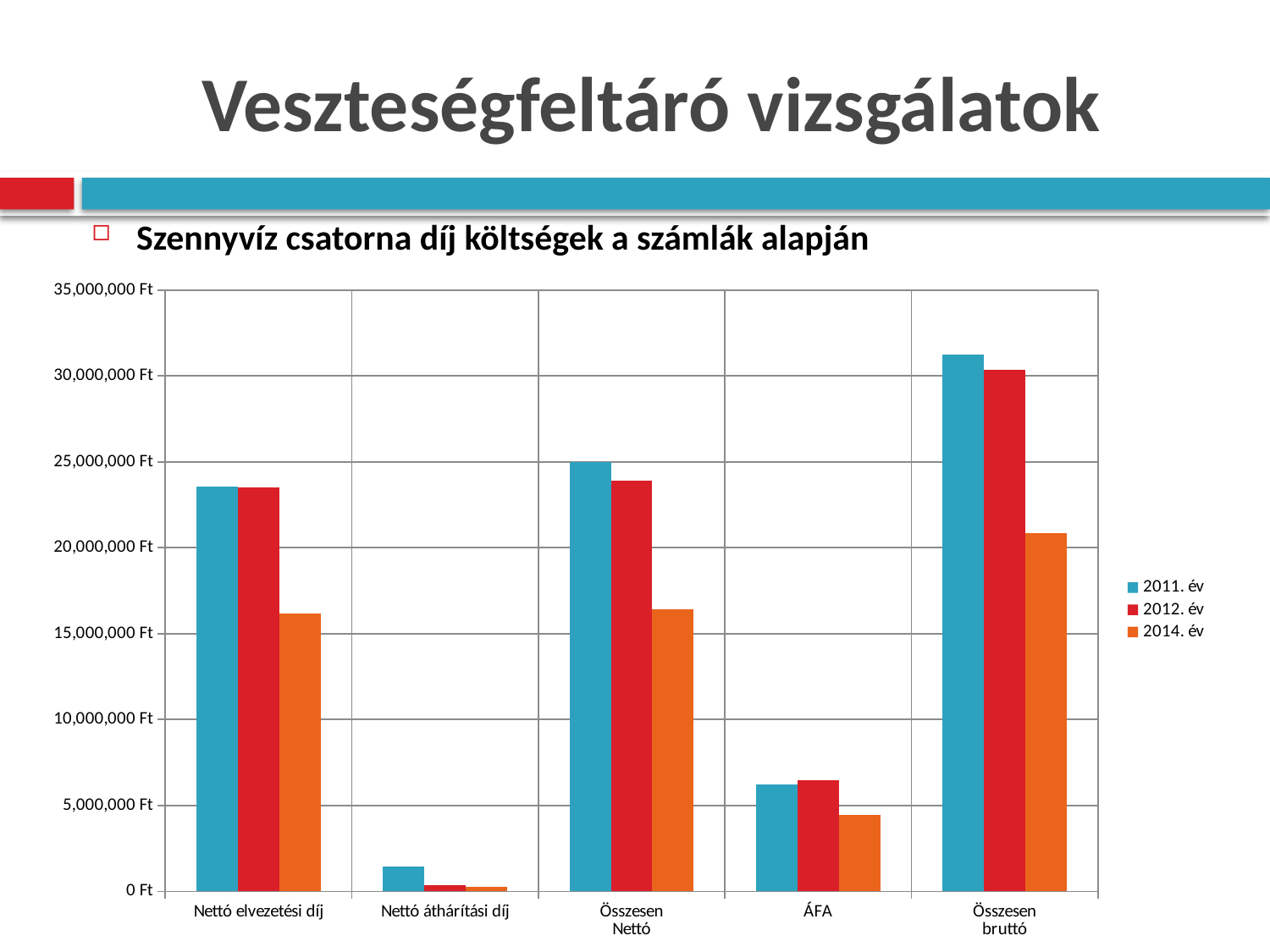
What kind of chart is shown on the slide? bar chart Which series is shown in orange in the legend? 2014. év How many categories are shown on the x axis? 5 Which category has the lowest value for the 2014. év series? Nettó áthárítási díj How many series does the legend list? 3 Is the 2011. év value for Összesen bruttó greater or less than 30,000,000 Ft? greater Is the 2011. év value for Nettó áthárítási díj greater or less than 5,000,000 Ft? less Is the 2014. év value for Nettó elvezetési díj greater or less than 15,000,000 Ft? greater For Összesen Nettó, which series has the larger value: 2011. év or 2012. év? 2011. év Which category has the highest value for the 2011. év series? Összesen bruttó For ÁFA, which series has the larger value: 2011. év or 2014. év? 2011. év